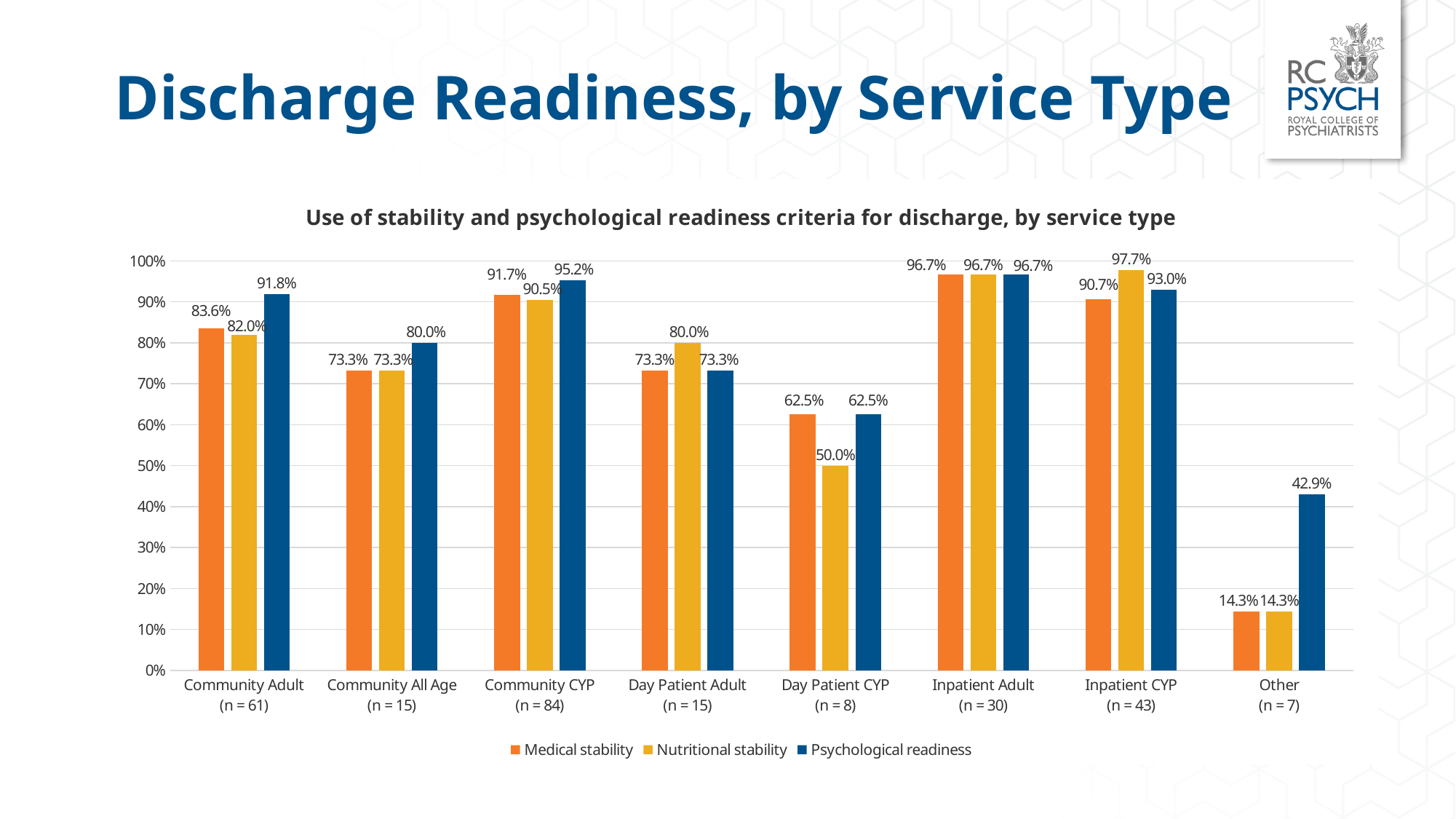
What is the Psychological readiness value for Community Adult? 91.8% How many service type categories are shown on the x axis? 8 How many series does the legend list? 3 What is the Medical stability value for Inpatient CYP? 90.7% What kind of chart is shown on the slide? Bar chart Which is larger for Day Patient Adult: Medical stability or Nutritional stability? Nutritional stability What is the Nutritional stability value for Day Patient CYP? 50.0% Is the Psychological readiness value for Other greater or less than 50%? less Which service type has the lowest Psychological readiness value? Other What is the difference between the Psychological readiness and Nutritional stability values for Other? 28.6% What is the sample size (n) shown for Community CYP? 84 Which service type has the highest Nutritional stability value? Inpatient CYP